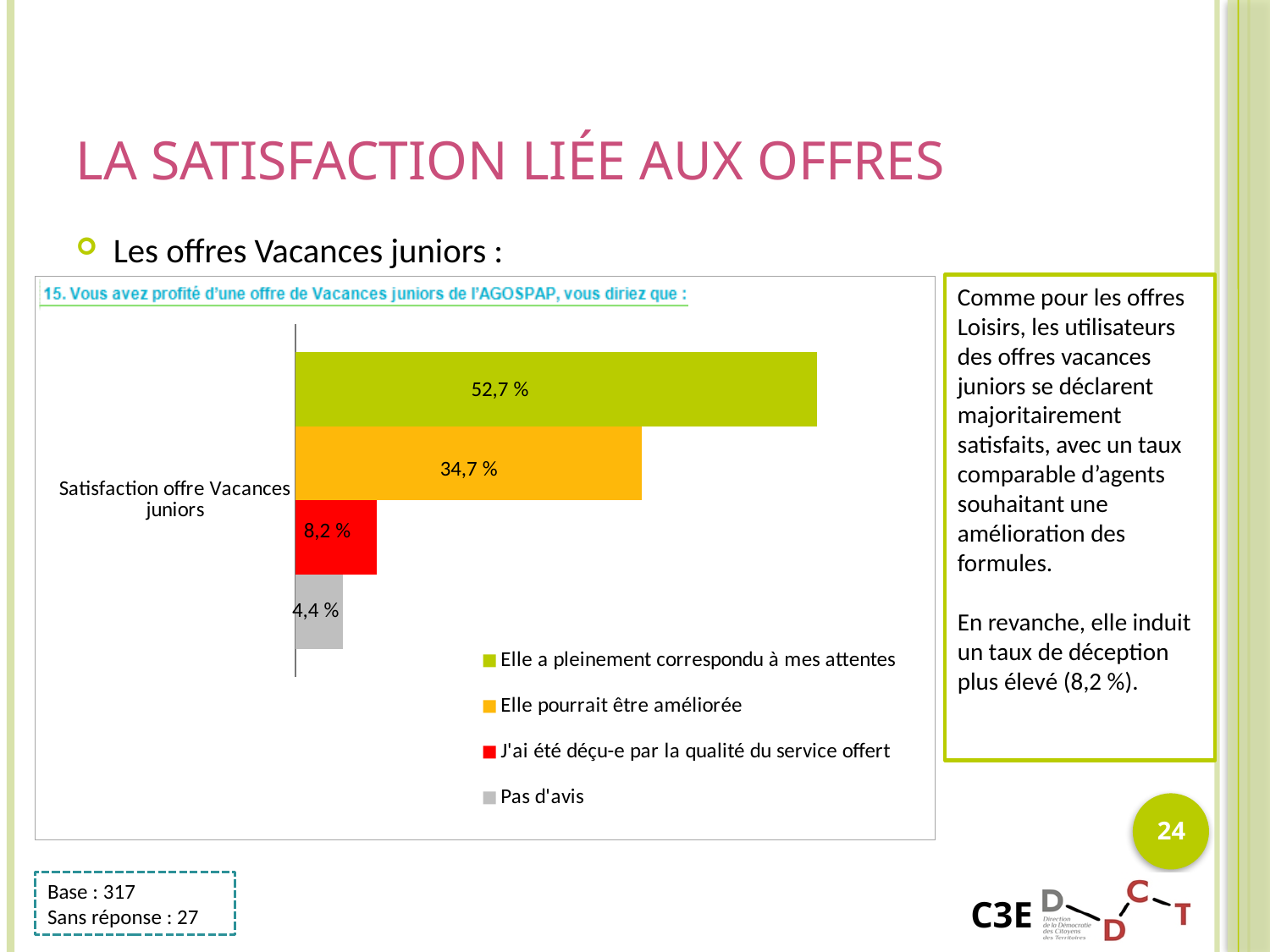
What is the value shown for "Pas d'avis"? 4,4 % What is the difference between the percentage for "J'ai été déçu-e par la qualité du service offert" and the percentage for "Pas d'avis"? 3,8 % Which is larger: the percentage for "Elle pourrait être améliorée" or the percentage for "J'ai été déçu-e par la qualité du service offert"? Elle pourrait être améliorée How many series does the chart legend list? 4 Which response has the lowest percentage in the chart? Pas d'avis What percentage of respondents said the Vacances juniors offer fully met their expectations ("Elle a pleinement correspondu à mes attentes")? 52,7 % What colour is the bar for "J'ai été déçu-e par la qualité du service offert"? Red What kind of chart is shown on the slide? Bar chart What is the value shown for "Elle pourrait être améliorée"? 34,7 % What percentage of respondents said they were disappointed by the quality of the service ("J'ai été déçu-e par la qualité du service offert")? 8,2 % What is the difference between the percentage for "Elle a pleinement correspondu à mes attentes" and the percentage for "Elle pourrait être améliorée"? 18,0 % Which response has the highest percentage in the chart? Elle a pleinement correspondu à mes attentes